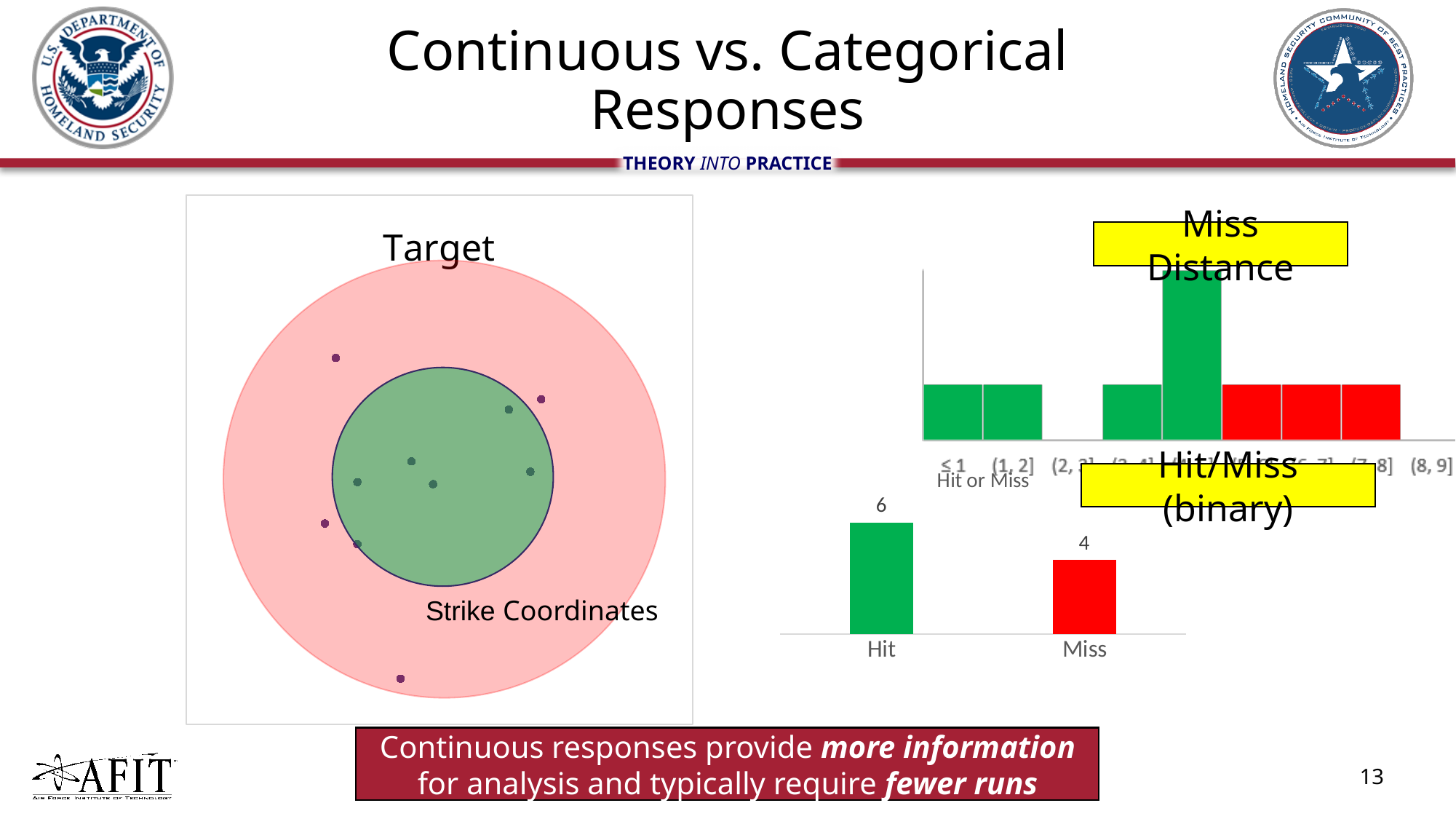
How many categories are shown in the Hit or Miss chart? 2 In the Miss Distance chart at the top right, how many bars are coloured red? 3 In the Hit or Miss chart, what is the value for Hit? 6 What kind of chart is the Hit or Miss chart? bar chart In the Hit or Miss chart, what is the value for Miss? 4 What kind of chart is the Miss Distance chart at the top right? bar chart In the Hit or Miss chart, which category has the higher value? Hit In the Hit or Miss chart, is the value for Hit larger or smaller than the value for Miss? larger In the Hit or Miss chart, what colour is the Miss bar? red In the Hit or Miss chart, what is the difference between the Hit and Miss values? 2 In the Hit or Miss chart, which category has the lower value? Miss In the Hit or Miss chart, what is the total of the Hit and Miss values? 10